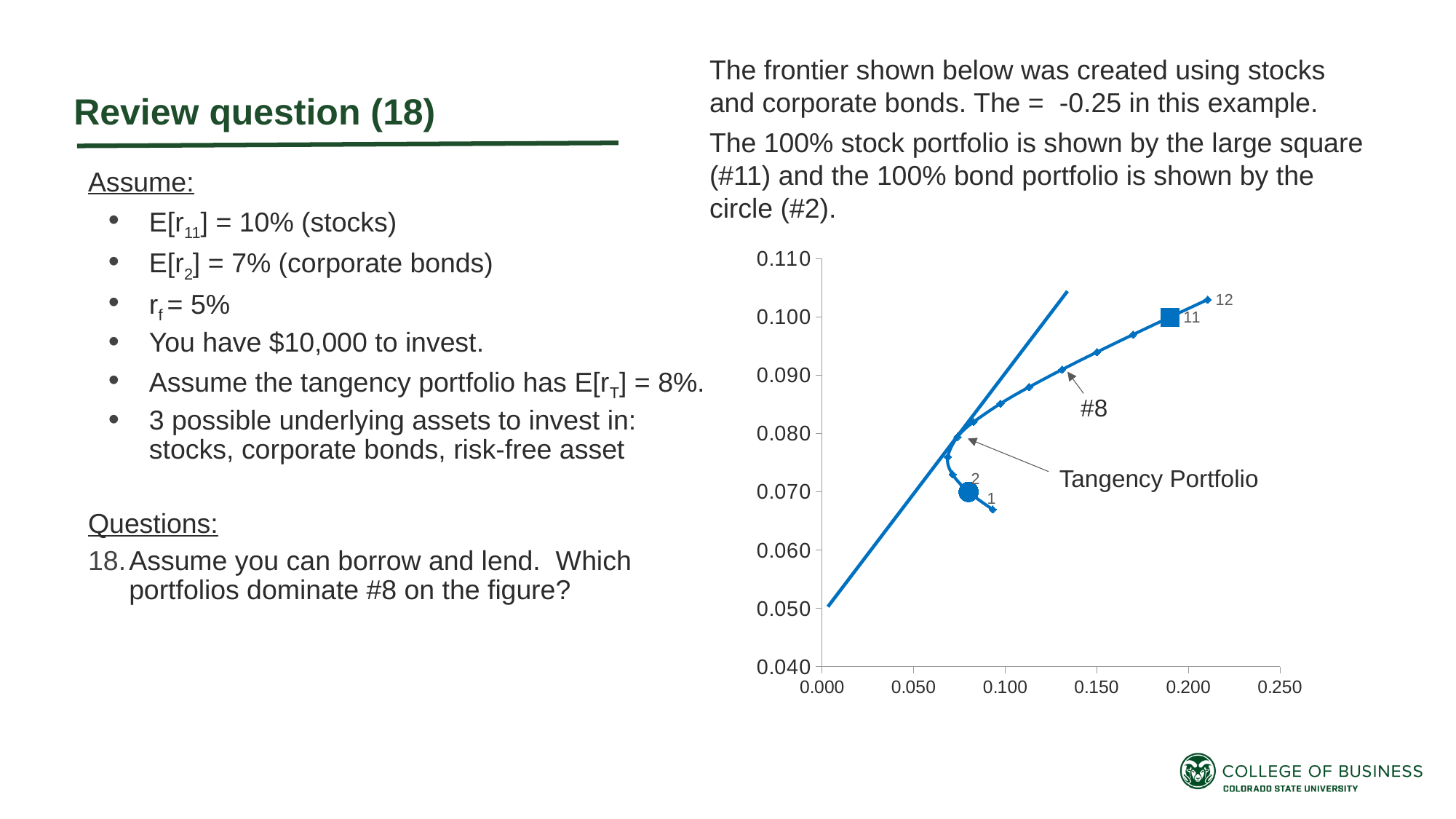
Is the y-axis value for point 12 greater or less than 0.100? greater Which labeled point on the frontier has the lowest y-axis value? 1 What is the y-axis value of point 2 (the circle) on the chart? 0.070 Which marker shape on the chart represents the 100% stock portfolio? the large square (#11) Is the x-axis value for point 2 greater or less than 0.100? less Is the y-axis value for point 1 greater or less than 0.070? less Which labeled point on the frontier has the highest y-axis value? 12 What is the highest value shown on the y-axis of the chart? 0.110 What is the y-axis value of point 11 (the large square) on the chart? 0.100 Which has the higher y-axis value, point 11 or point 2? point 11 What kind of chart is shown on the slide? scatter chart